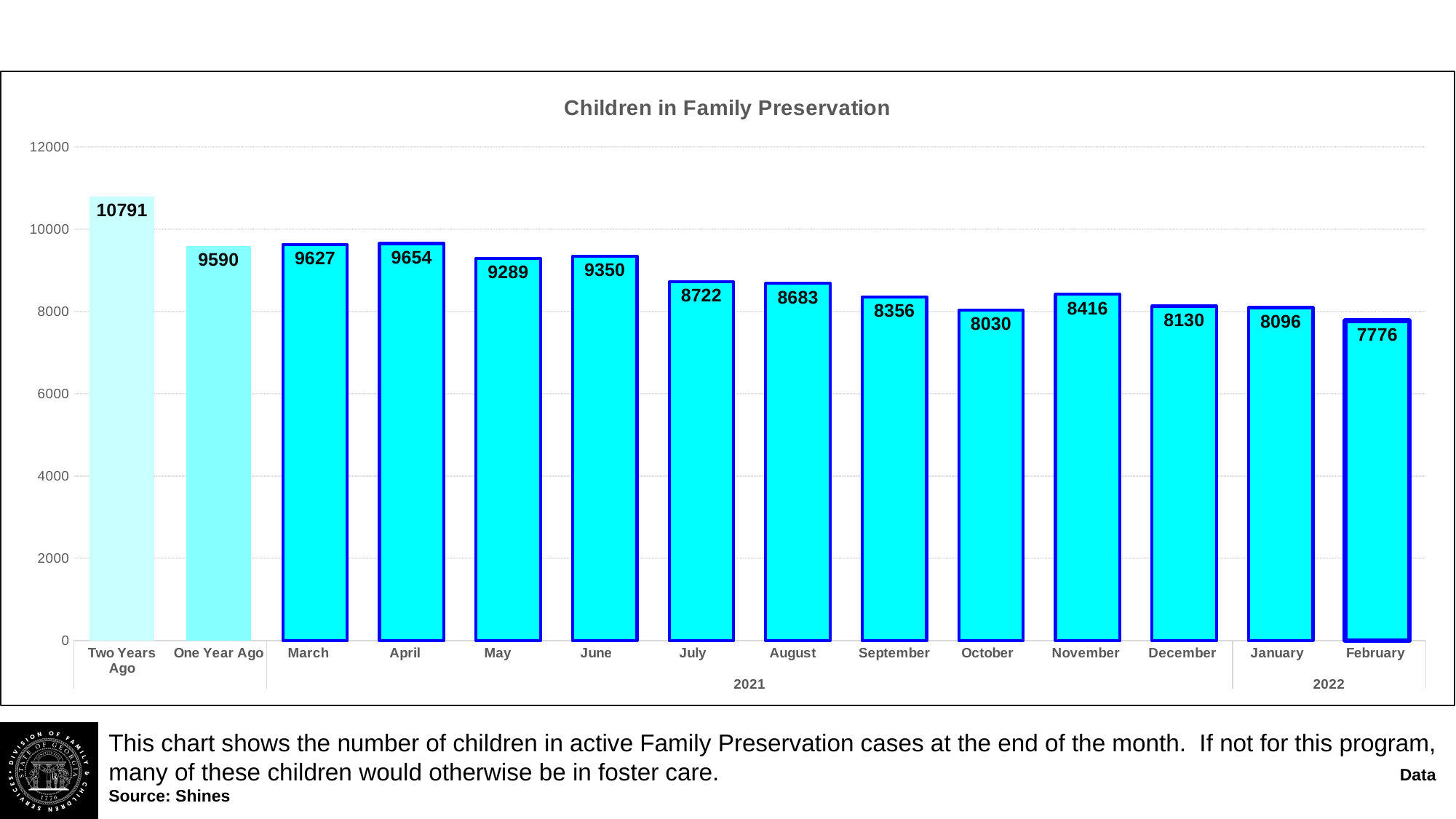
Do the values generally rise or fall from March 2021 to February 2022? Fall What is the value for February 2022 in the Children in Family Preservation chart? 7776 What is the value for Two Years Ago in the Children in Family Preservation chart? 10791 Which is larger, the value for July or the value for August? July How many bars are shown in the Children in Family Preservation chart? 14 Which category has the highest value in the Children in Family Preservation chart? Two Years Ago What kind of chart is shown on the slide? Bar chart Is the value for September greater or less than 8000? greater What is the value for April 2021 in the Children in Family Preservation chart? 9654 What is the difference between the values for Two Years Ago and One Year Ago? 1201 What is the difference between the values for October 2021 and November 2021? 386 Which category has the lowest value in the Children in Family Preservation chart? February